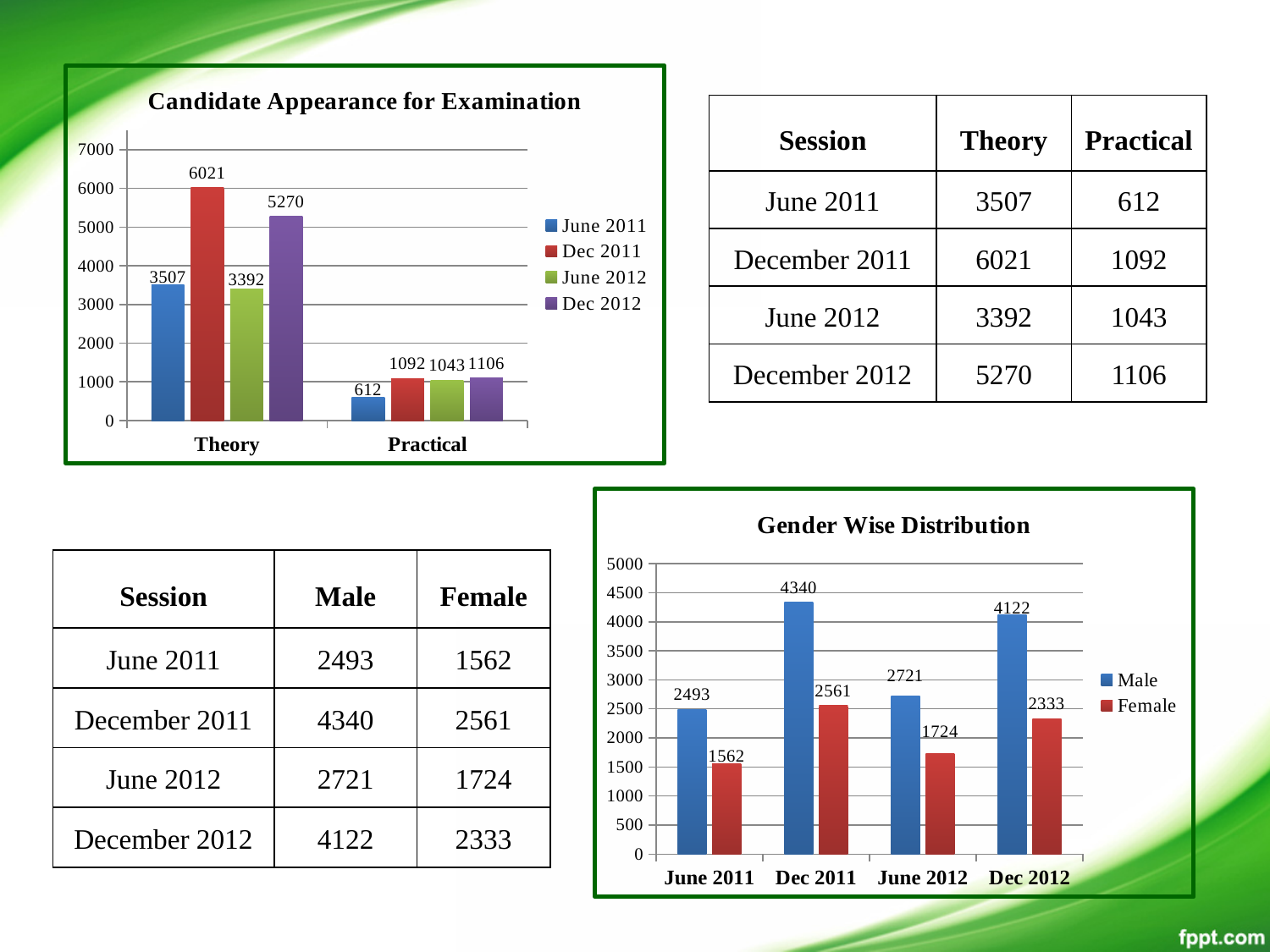
In the 'Candidate Appearance for Examination' chart, how many series does the legend list? 4 In the 'Gender Wise Distribution' chart, how many sessions are shown on the x axis? 4 In the 'Candidate Appearance for Examination' chart, which series has the highest Theory value? Dec 2011 In the 'Candidate Appearance for Examination' chart, what is the difference between the Theory values for Dec 2011 and June 2012? 2629 In the 'Candidate Appearance for Examination' chart, what is the Practical value for June 2011? 612 In the 'Gender Wise Distribution' chart, what is the Female value for June 2012? 1724 In the 'Gender Wise Distribution' chart, which session has the lowest Female value? June 2011 In the 'Gender Wise Distribution' chart, which session has the highest Male value? Dec 2011 In the 'Candidate Appearance for Examination' chart, is the Theory value for Dec 2012 greater or less than 5000? greater In the 'Candidate Appearance for Examination' chart, what is the Theory value for Dec 2011? 6021 In the 'Gender Wise Distribution' chart, what is the difference between the Male and Female values for Dec 2012? 1789 What kind of chart is the 'Gender Wise Distribution' chart? bar chart